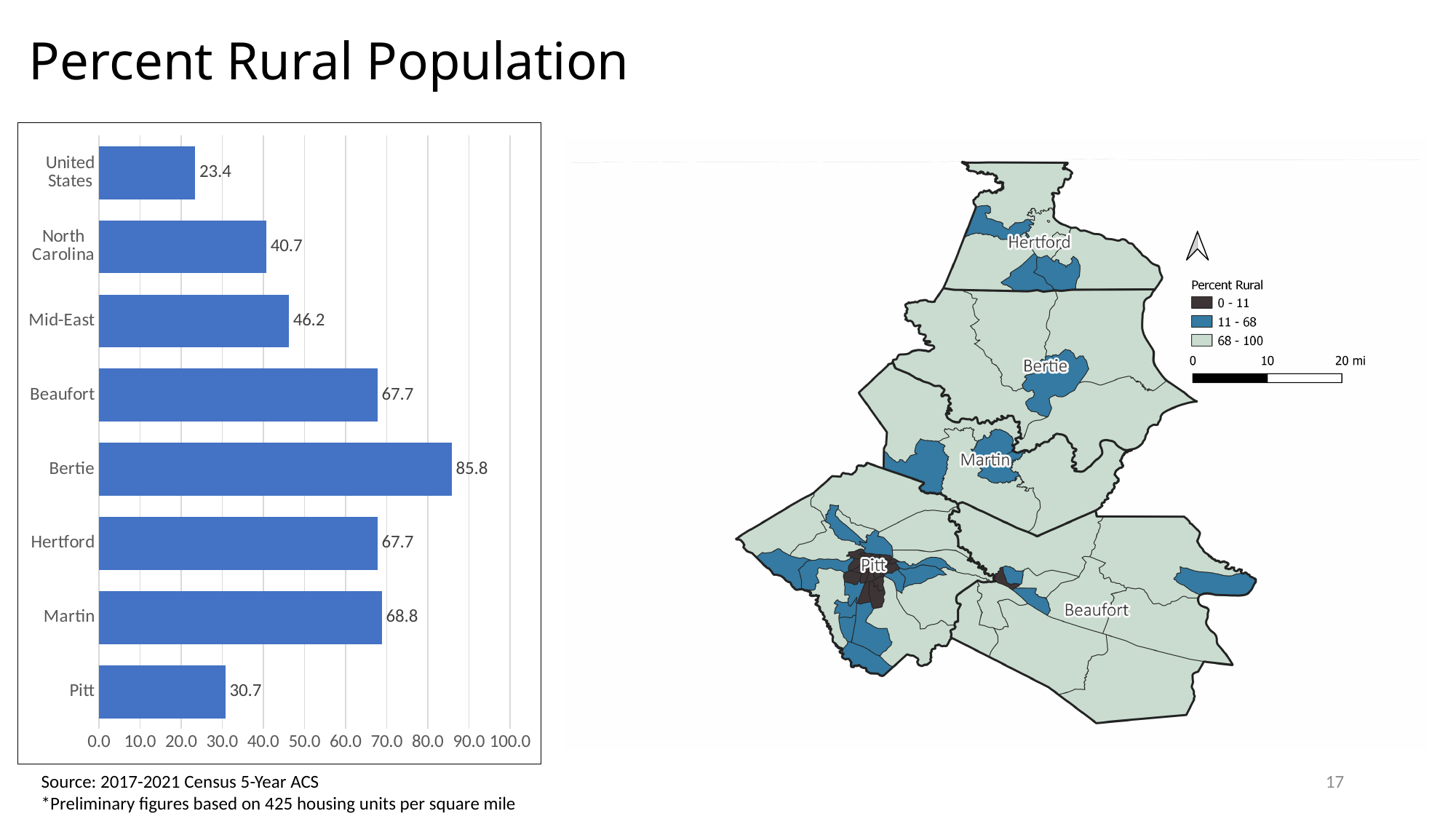
What kind of chart is shown on the left of the slide? Bar chart What is the value shown for Pitt in the bar chart? 30.7 What is the value shown for North Carolina in the bar chart? 40.7 What is the title of the slide containing the bar chart? Percent Rural Population What is the difference between the values for Bertie and Martin in the bar chart? 17.0 What is the value shown for the United States in the bar chart? 23.4 What is the percent rural population value for Bertie in the bar chart? 85.8 How many categories are shown in the bar chart? 8 Which has a larger value in the bar chart, Martin or Pitt? Martin Which category has the lowest value in the bar chart? United States What is the difference between the values for Mid-East and North Carolina in the bar chart? 5.5 Which category has the highest value in the bar chart? Bertie